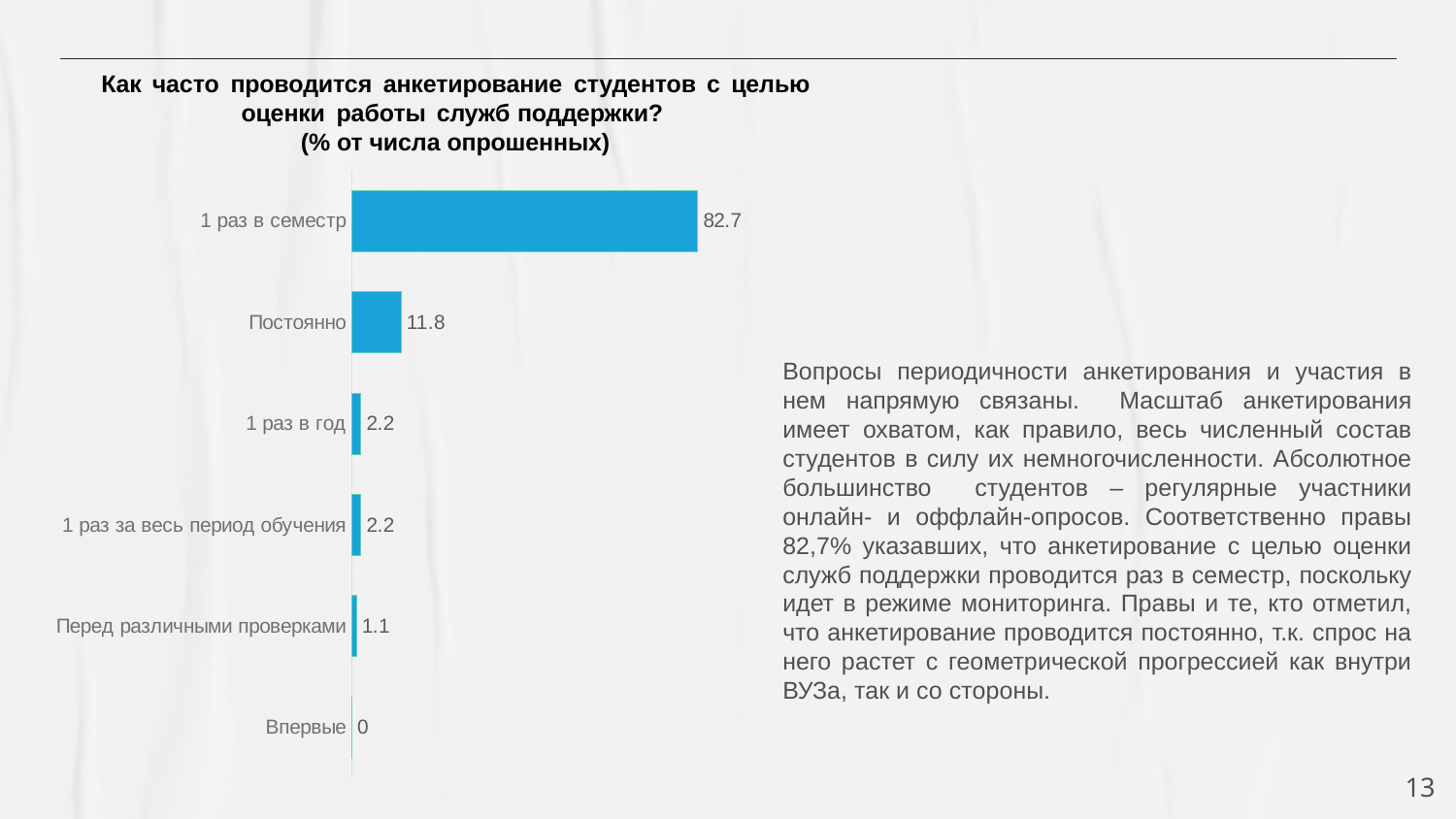
What is the value for "1 раз в семестр"? 82.7 Which category has the lowest value? Впервые What is the value for "Постоянно"? 11.8 What is the difference between the values for "1 раз в год" and "Перед различными проверками"? 1.1 What is the value for "Перед различными проверками"? 1.1 Which category has the highest value? 1 раз в семестр What kind of chart is shown on the slide? Bar chart Which is larger, the value for "Постоянно" or the value for "1 раз в год"? Постоянно How many categories are shown in the chart? 6 What unit does the chart title say the values are in? % от числа опрошенных What is the value for "Впервые"? 0 What is the difference between the values for "1 раз в семестр" and "Постоянно"? 70.9